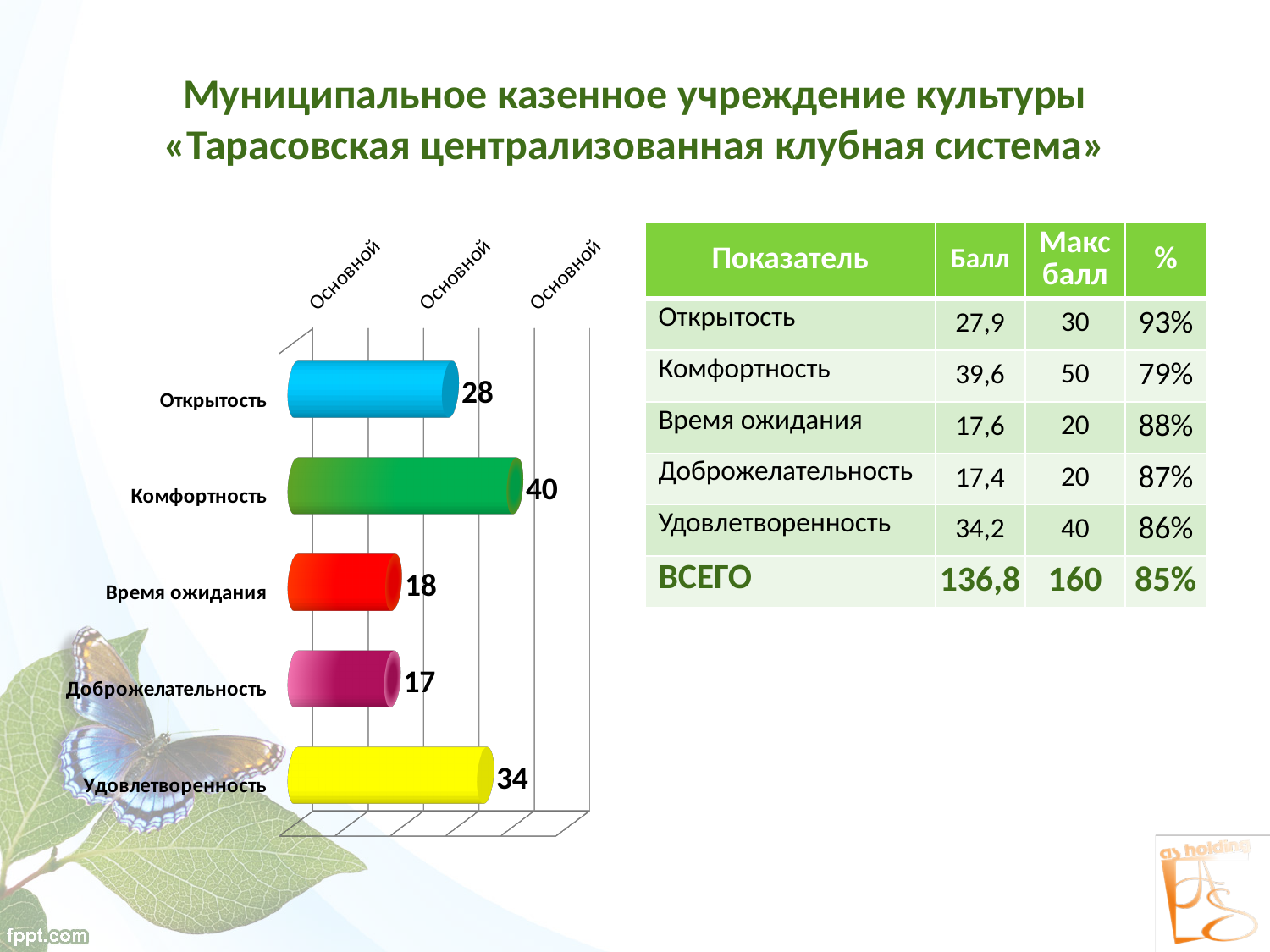
What is the difference between the values for Комфортность and Открытость? 12 How many categories are shown in the chart? 5 Which category has the highest value in the chart? Комфортность What value does the chart show for Комфортность? 40 Which category has the lowest value in the chart? Доброжелательность What value does the chart show for Удовлетворенность? 34 What value does the chart show for Доброжелательность? 17 Which is larger, the value for Открытость or the value for Удовлетворенность? Удовлетворенность What value does the chart show for Открытость? 28 What kind of chart is shown on the slide? bar chart What is the difference between the values for Удовлетворенность and Время ожидания? 16 What colour is the bar for Время ожидания? red